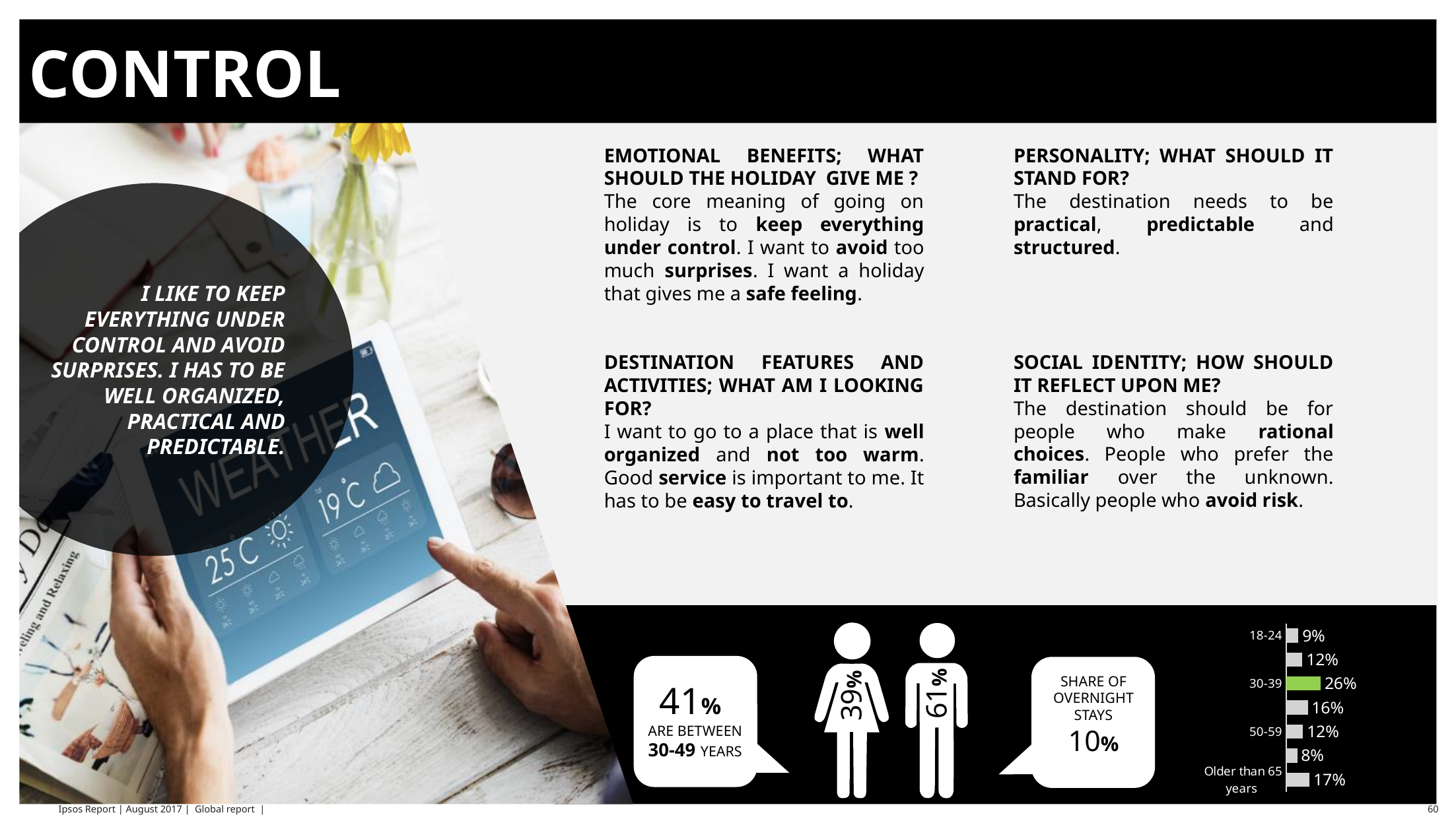
In the bar chart at the bottom right, what is the difference between the 'Older than 65 years' value and the 50-59 value? 5 percentage points In the bar chart at the bottom right, which age group's bar is coloured green? 30-39 In the bar chart at the bottom right, what is the value for the 50-59 age group? 12% In the bar chart at the bottom right, what is the smallest value shown? 8% In the bar chart at the bottom right, how many bars are plotted? 7 In the bar chart at the bottom right, what is the difference between the 30-39 value and the 18-24 value? 17 percentage points In the bar chart at the bottom right, which is larger: the value for 18-24 or the value for 50-59? 50-59 In the bar chart at the bottom right, what is the value for the 18-24 age group? 9% In the bar chart at the bottom right, what is the value for the 30-39 age group? 26% In the bar chart at the bottom right, what is the value for the 'Older than 65 years' group? 17% In the bar chart at the bottom right, which age group has the highest value? 30-39 What kind of chart is shown at the bottom right of the slide? bar chart